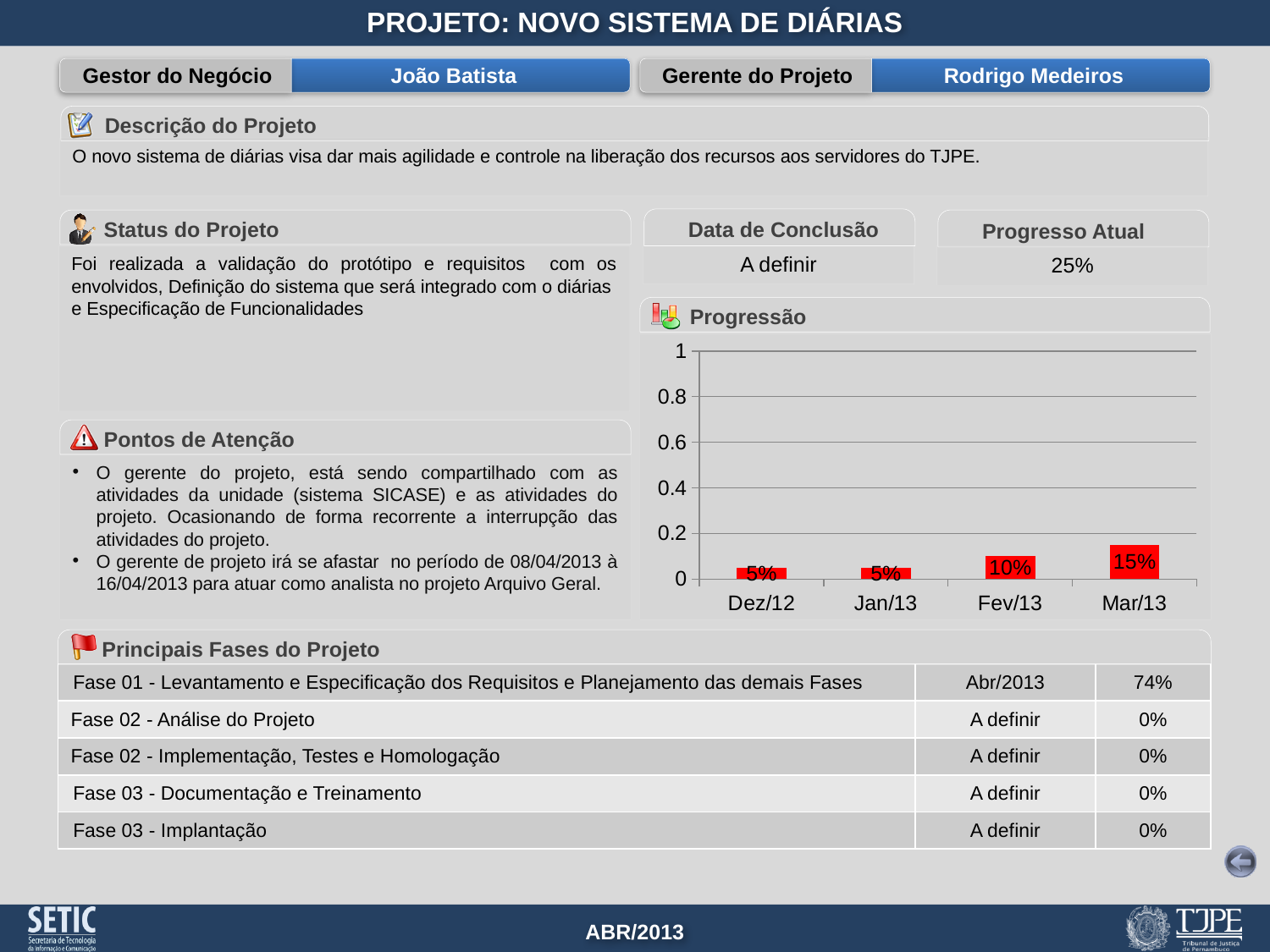
Which is larger in the Progressão chart, the value for Fev/13 or the value for Jan/13? Fev/13 What is the value for Jan/13 in the Progressão chart? 5% What is the value for Fev/13 in the Progressão chart? 10% How many categories are shown on the x axis of the Progressão chart? 4 What is the difference between the values for Mar/13 and Fev/13 in the Progressão chart? 5% What is the difference between the values for Mar/13 and Dez/12 in the Progressão chart? 10% What kind of chart is the Progressão chart? bar chart What is the value for Mar/13 in the Progressão chart? 15% What is the value for Dez/12 in the Progressão chart? 5% Which category has the highest value in the Progressão chart? Mar/13 Do the values in the Progressão chart rise or fall from Dez/12 to Mar/13? rise Is the value for Mar/13 in the Progressão chart greater or less than 0.2? less